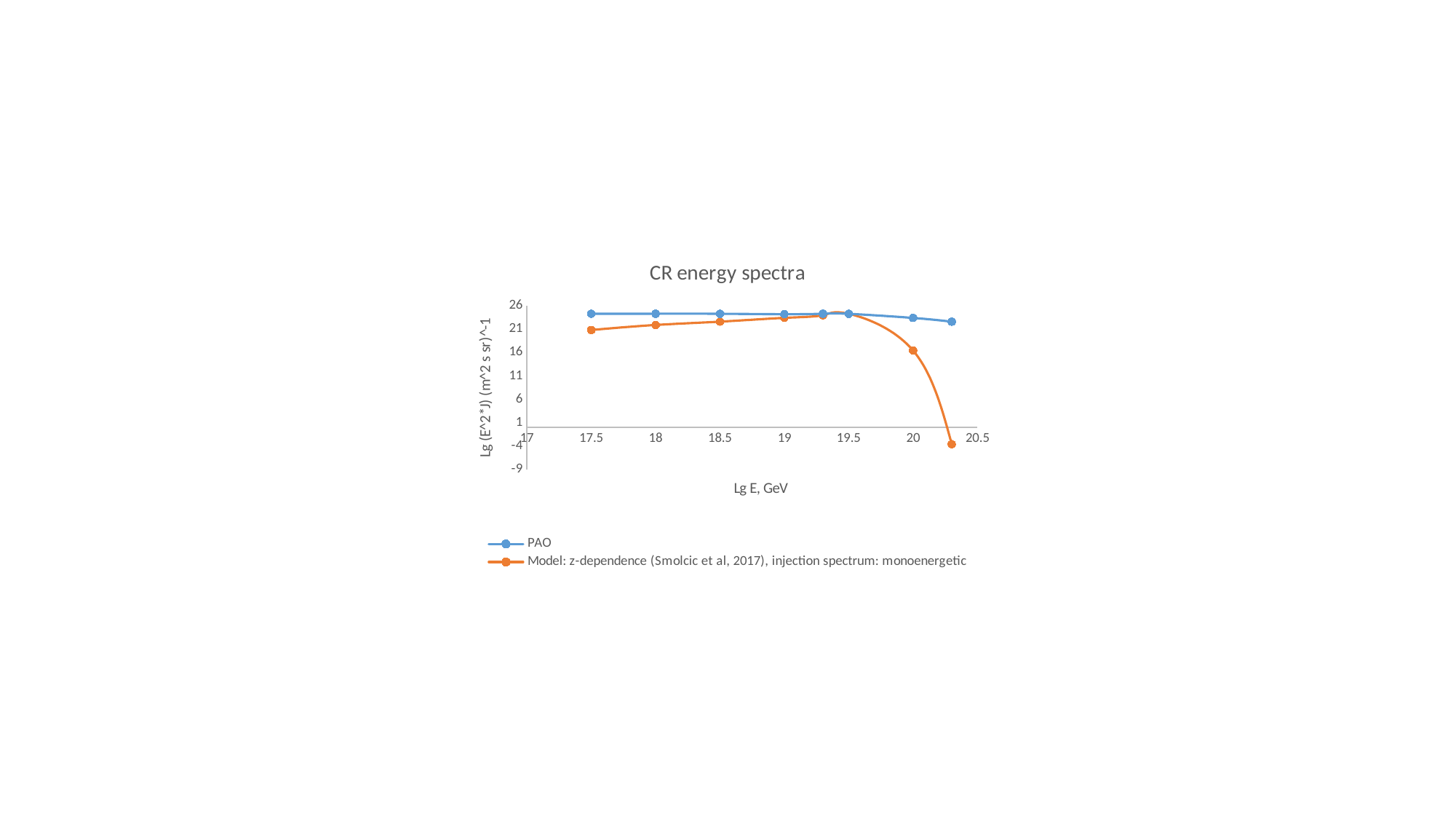
What is the title of the chart? CR energy spectra At Lg E = 20.3, which series has the higher value, PAO or the Model? PAO Is the value of the PAO series at Lg E = 17.5 greater or less than 21? greater Is the value of the Model series at Lg E = 20.3 greater or less than 1? less What is the label of the x axis? Lg E, GeV Is the value of the Model series at Lg E = 20 greater or less than 11? greater Does the Model series rise or fall between Lg E = 17.5 and Lg E = 19? Rise How many series does the legend list? 2 What kind of chart is shown on the slide? Line chart Does the Model series rise or fall between Lg E = 19.5 and Lg E = 20.3? Fall At Lg E = 17.5, which series has the higher value, PAO or the Model? PAO